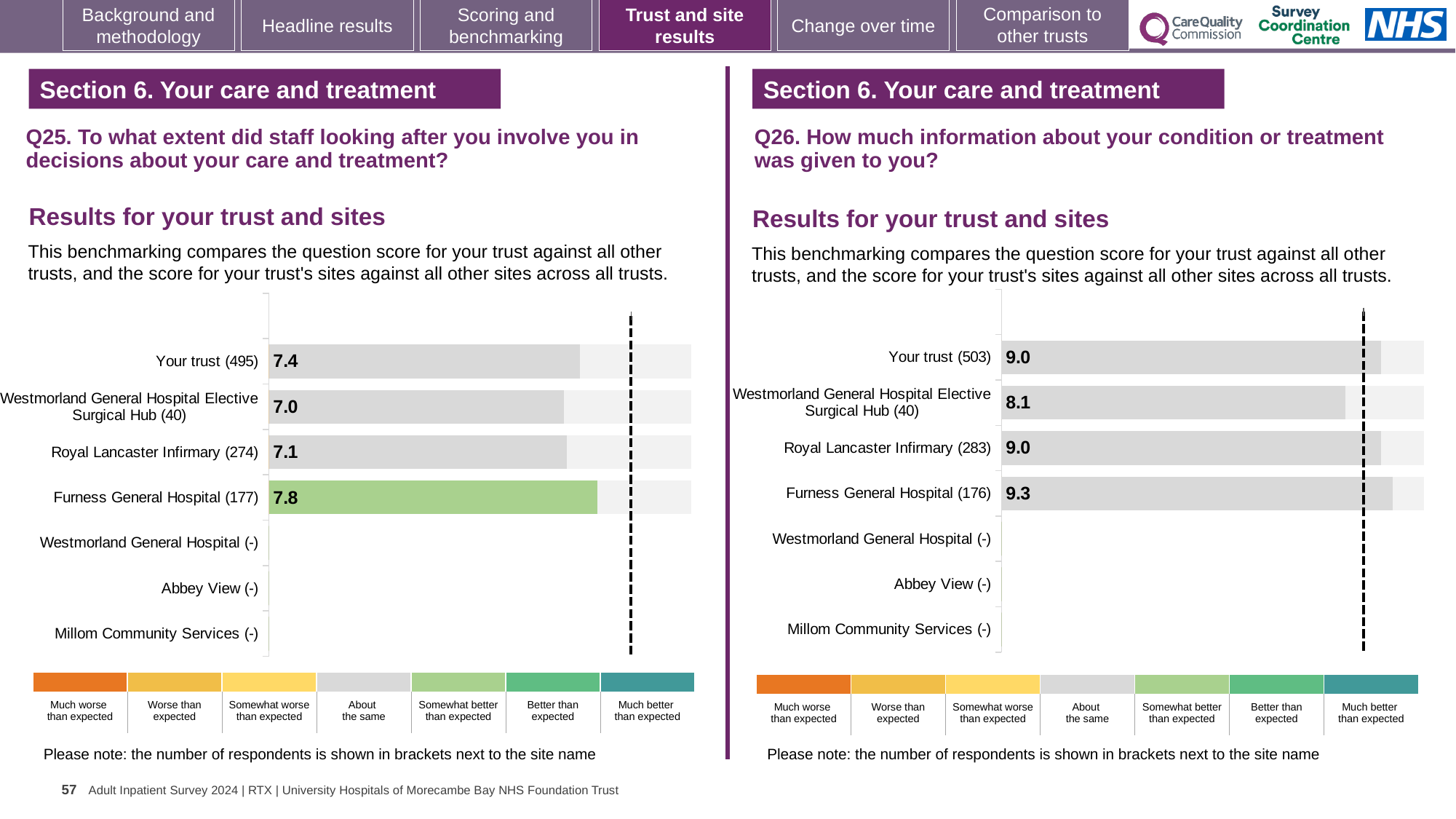
On the Q25 chart on the left, what is the score for Your trust? 7.4 On the Q25 chart on the left, what is the score for Furness General Hospital? 7.8 On the Q26 chart on the right, what is the score for Furness General Hospital? 9.3 On the Q26 chart on the right, what is the score for Westmorland General Hospital Elective Surgical Hub? 8.1 On the Q26 chart on the right, which site has the highest score? Furness General Hospital What kind of chart is the Q26 chart on the right? Bar chart How many site categories are listed on the Q25 chart on the left? 7 On the Q26 chart on the right, which is larger: the score for Your trust or the score for Westmorland General Hospital Elective Surgical Hub? Your trust On the Q25 chart on the left, which site has the lowest score? Westmorland General Hospital Elective Surgical Hub On the Q26 chart on the right, what is the difference between the scores for Furness General Hospital and Westmorland General Hospital Elective Surgical Hub? 1.2 On the Q25 chart on the left, which site's bar is coloured green? Furness General Hospital On the Q25 chart on the left, what is the difference between the scores for Furness General Hospital and Royal Lancaster Infirmary? 0.7